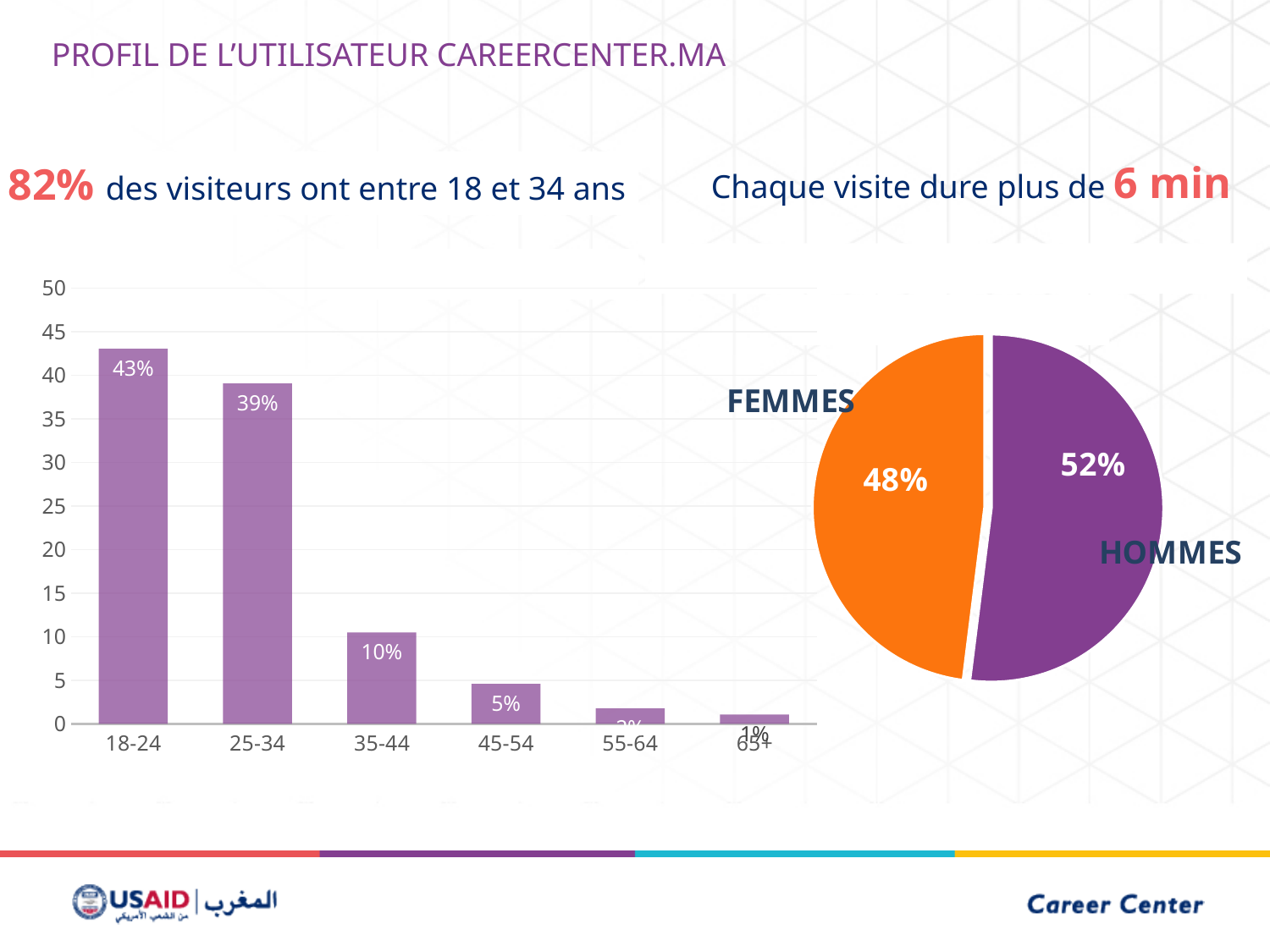
In the bar chart on the left, is the value for 55-64 greater or less than 5? less In the pie chart on the right, which slice is larger, FEMMES or HOMMES? HOMMES In the bar chart on the left, what is the value for the 25-34 age group? 39% In the bar chart on the left, which is larger, the value for 35-44 or the value for 45-54? 35-44 In the pie chart on the right, what share is labelled HOMMES? 52% In the bar chart on the left, what is the value for the 45-54 age group? 5% In the bar chart on the left, what is the value for the 18-24 age group? 43% In the bar chart on the left, which age group has the highest value? 18-24 In the bar chart on the left, what is the value for the 35-44 age group? 10% How many age groups are shown in the bar chart on the left? 6 In the bar chart on the left, which age group has the lowest value? 65+ In the bar chart on the left, what is the difference between the values for 18-24 and 25-34? 4%